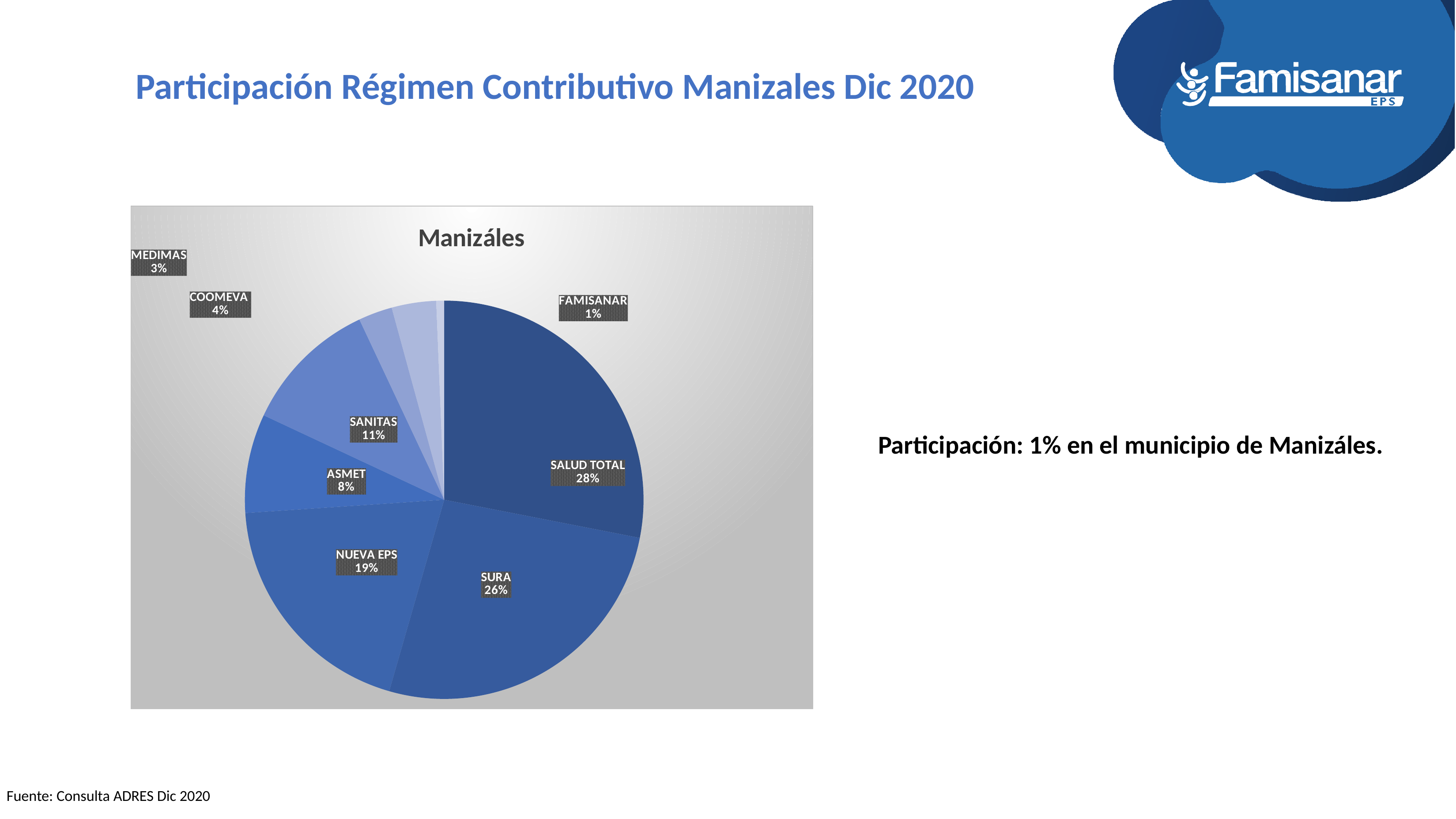
What share of the pie does SALUD TOTAL hold? 28% What is the value shown for FAMISANAR? 1% What kind of chart is shown on the slide? Pie chart What is the value shown for SANITAS? 11% Which is larger, the share of ASMET or the share of COOMEVA? ASMET Which category has the smallest share of the pie? FAMISANAR Which category has the largest share of the pie? SALUD TOTAL How many categories are shown in the pie chart? 8 What is the difference between the shares of SALUD TOTAL and SURA? 2% What is the title of the chart? Manizáles What is the value shown for SURA? 26% What is the value shown for NUEVA EPS? 19%